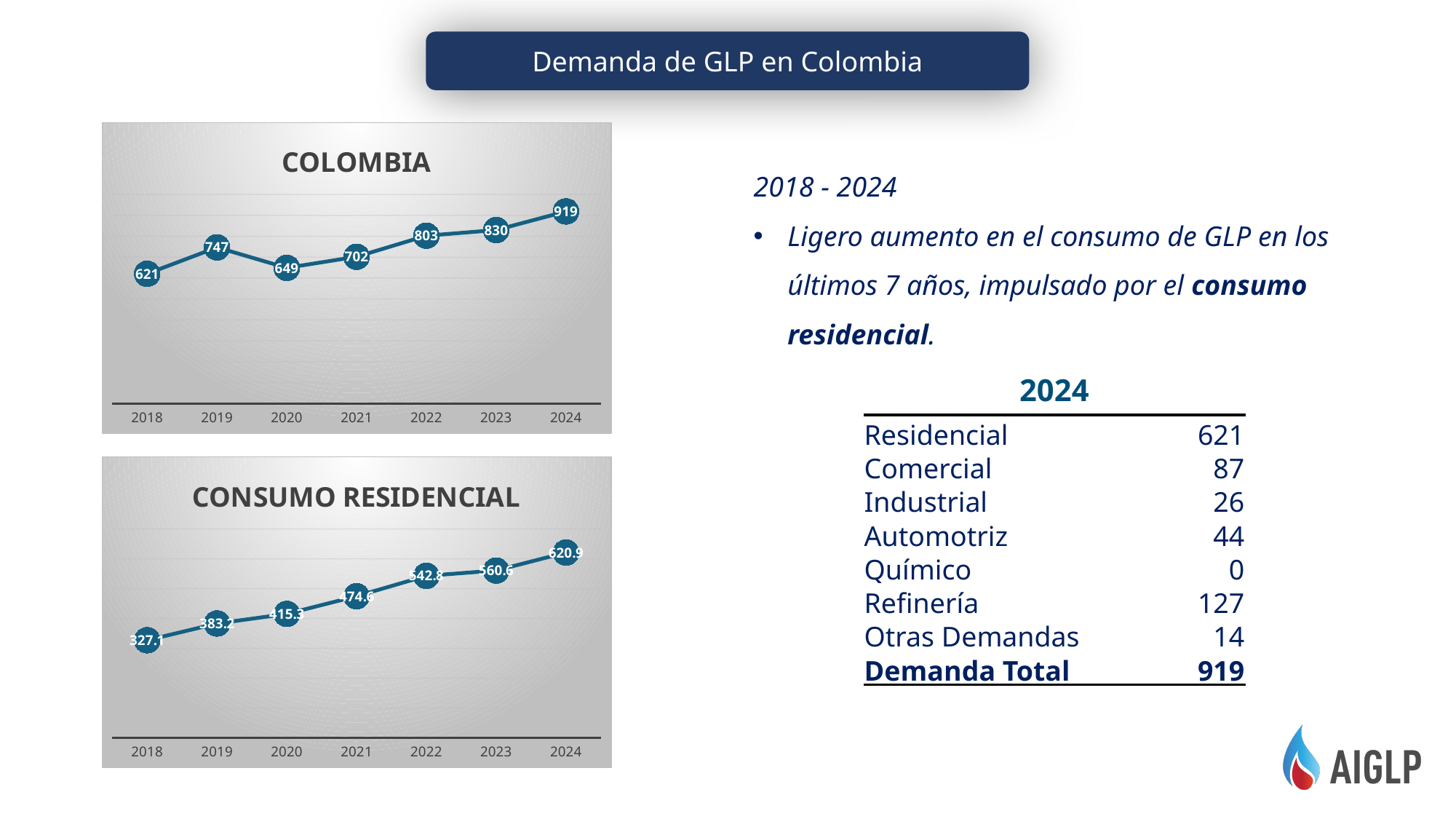
In the CONSUMO RESIDENCIAL chart, what is the value for 2024? 620.9 In the COLOMBIA chart, which year has the lowest value? 2018 What kind of chart is the CONSUMO RESIDENCIAL chart? Line chart In the CONSUMO RESIDENCIAL chart, do the values rise or fall from 2018 to 2024? Rise In the CONSUMO RESIDENCIAL chart, what is the difference between the values for 2019 and 2018? 56.1 In the COLOMBIA chart, what is the value for 2018? 621 In the COLOMBIA chart, what is the value for 2022? 803 In the COLOMBIA chart, which year has the highest value? 2024 In the CONSUMO RESIDENCIAL chart, what is the value for 2021? 474.6 In the COLOMBIA chart, what is the difference between the values for 2024 and 2023? 89 In the COLOMBIA chart, how many years are plotted? 7 In the COLOMBIA chart, which is larger, the value for 2019 or the value for 2020? 2019